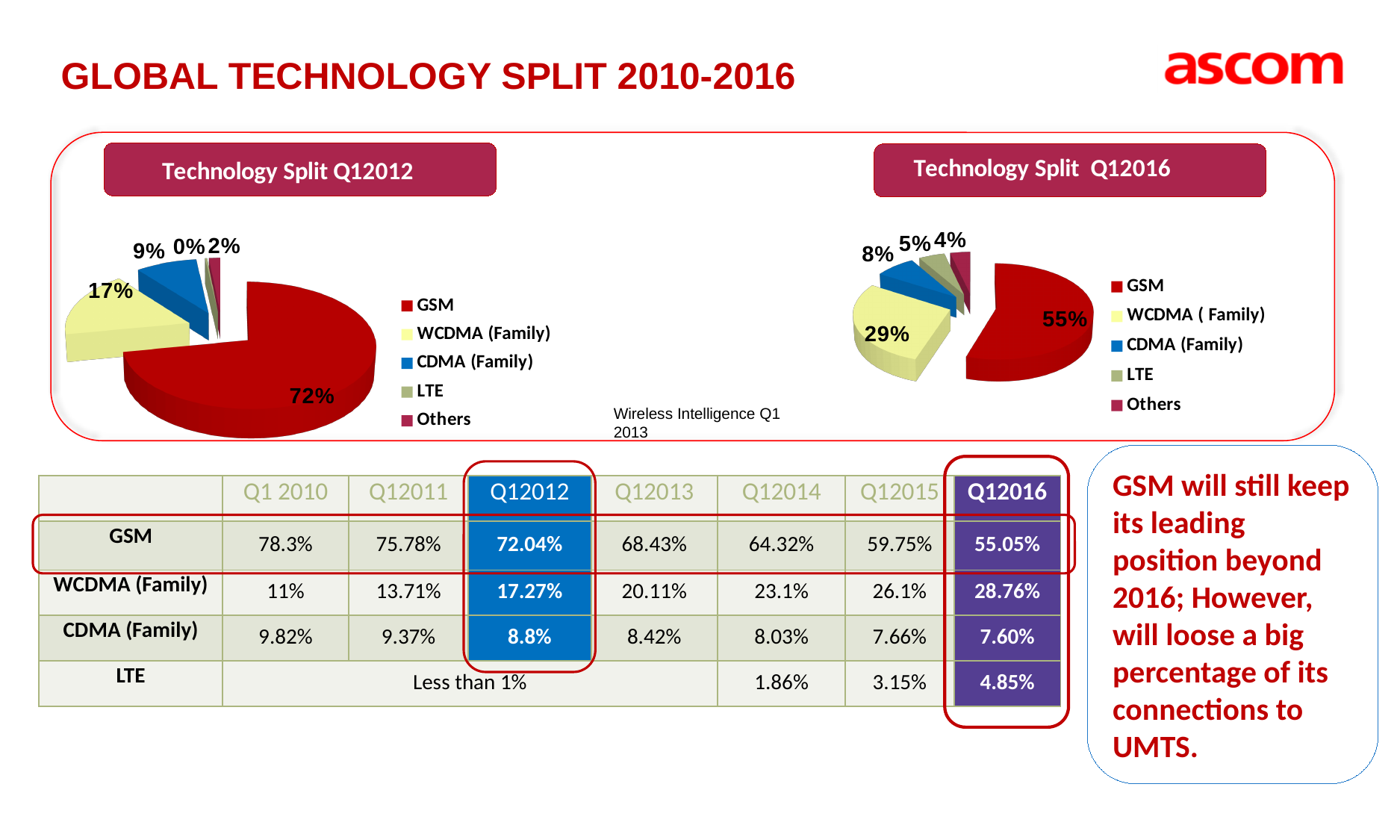
In the Technology Split Q12012 pie chart, which category has the smallest slice? LTE In the Technology Split Q12012 pie chart, which category has the largest slice? GSM In the Technology Split Q12016 pie chart, what share does LTE have? 5% In the Technology Split Q12016 pie chart, what share does GSM have? 55% What is the difference between the GSM share in the Technology Split Q12012 chart and the GSM share in the Technology Split Q12016 chart? 17% In the Technology Split Q12016 pie chart, which category has the smallest slice? Others What type of chart is the Technology Split Q12016 chart? Pie chart In the Technology Split Q12012 pie chart, what share does GSM have? 72% How many entries does the legend of the Technology Split Q12012 chart list? 5 In the Technology Split Q12016 pie chart, which is larger, the CDMA (Family) slice or the LTE slice? CDMA (Family) In the Technology Split Q12016 pie chart, what share does WCDMA ( Family) have? 29% In the Technology Split Q12012 pie chart, what share does WCDMA (Family) have? 17%